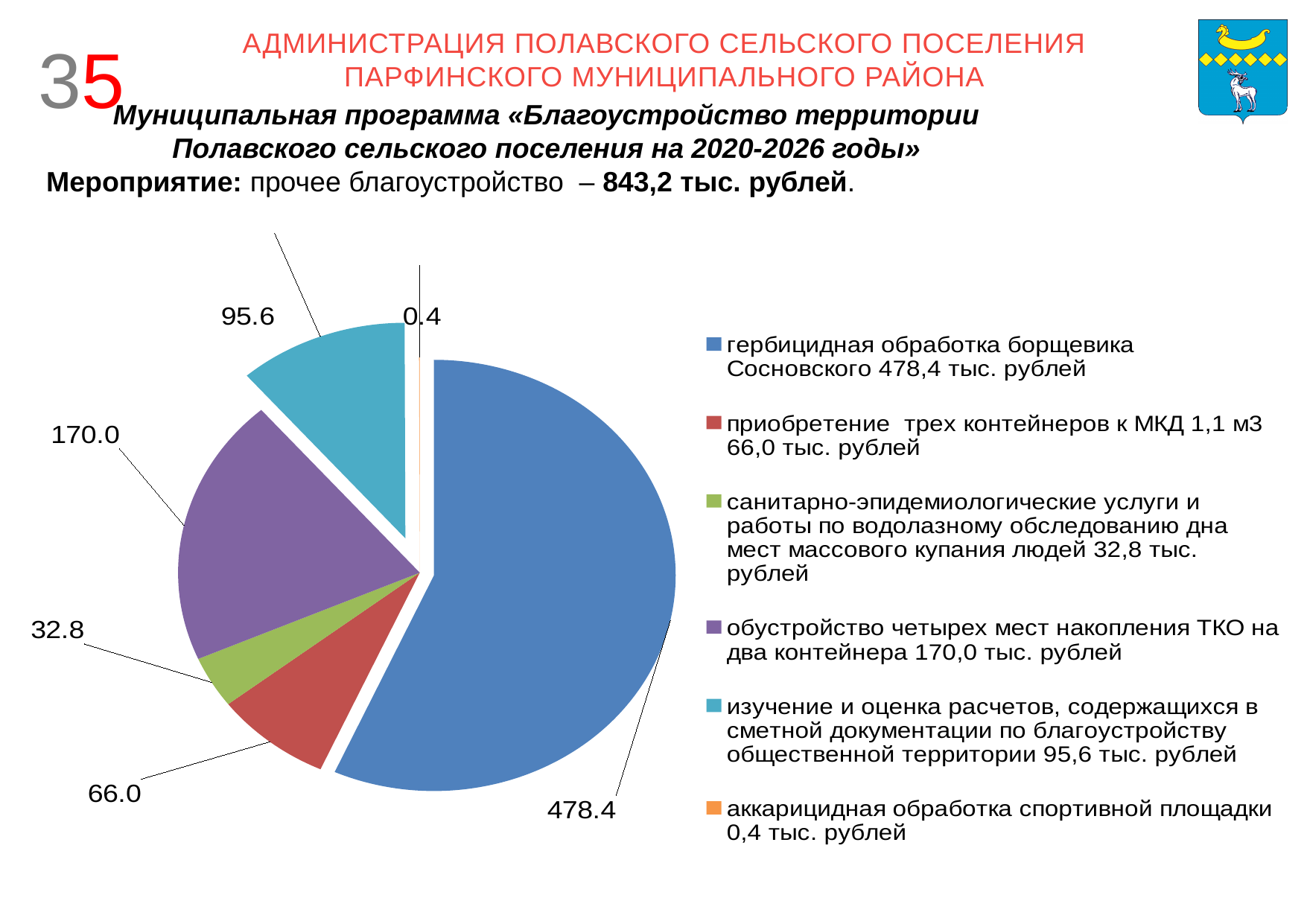
What is the value of the slice for приобретение трех контейнеров к МКД 1,1 м3? 66.0 What is the difference between the slice for гербицидная обработка борщевика Сосновского (478.4) and the slice for обустройство четырех мест накопления ТКО (170.0)? 308.4 How many entries does the legend of the pie chart list? 6 What is the value of the slice for аккарицидная обработка спортивной площадки? 0.4 Which category has the largest slice in the pie chart? гербицидная обработка борщевика Сосновского Which category has the smallest slice in the pie chart? аккарицидная обработка спортивной площадки What type of chart is shown on the slide? pie chart How many slices does the pie chart have? 6 What is the value of the slice for гербицидная обработка борщевика Сосновского? 478.4 What is the value of the slice for обустройство четырех мест накопления ТКО на два контейнера? 170.0 Which is larger: the slice for изучение и оценка расчетов в сметной документации (95.6) or the slice for приобретение трех контейнеров к МКД (66.0)? изучение и оценка расчетов в сметной документации What colour is the slice for санитарно-эпидемиологические услуги и работы по водолазному обследованию дна? green